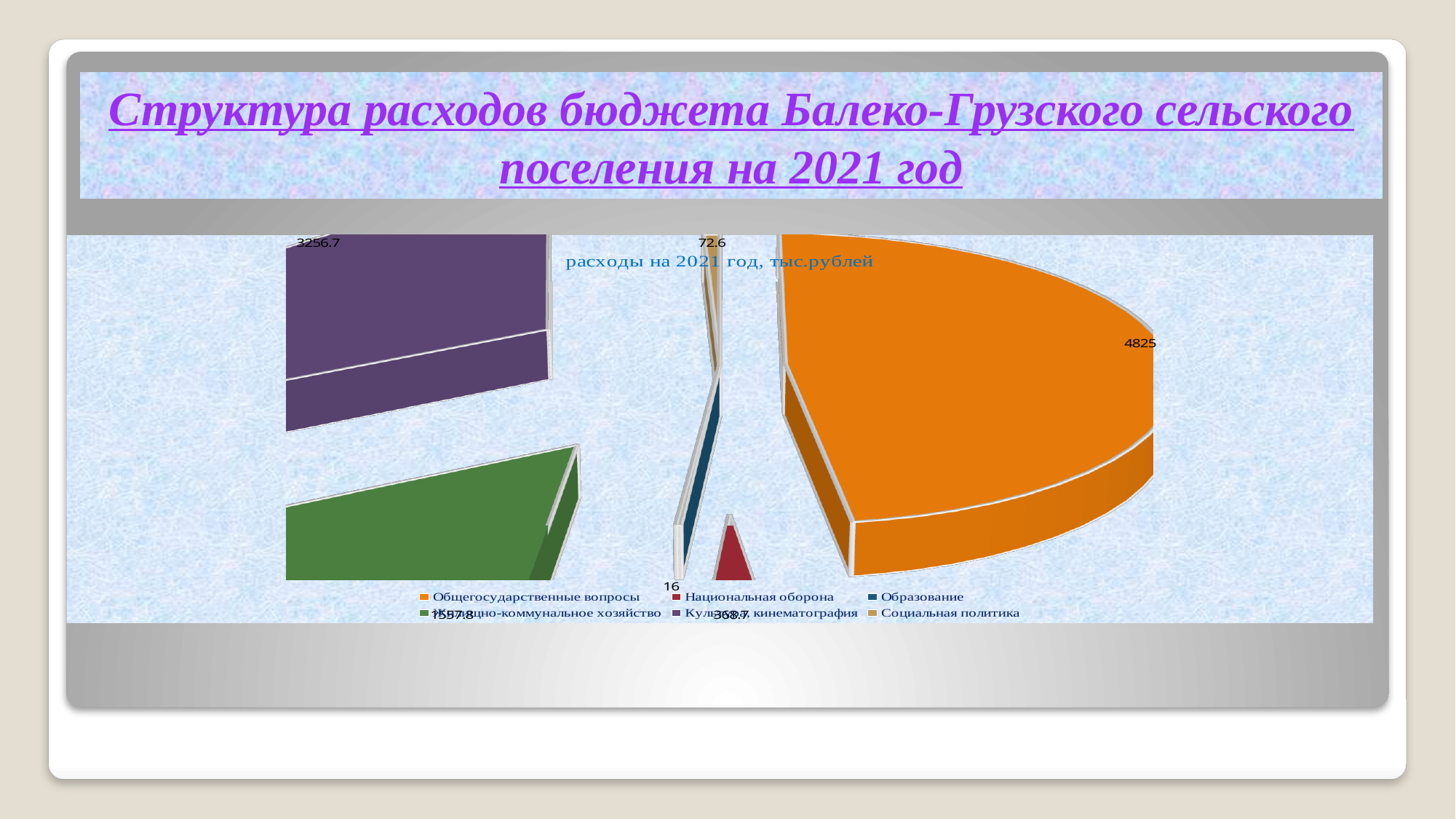
What is the value for Социальная политика? 72.6 Which category has the smallest slice of the pie? Образование Which category has the largest slice of the pie? Общегосударственные вопросы Which is larger, the value for Социальная политика or the value for Образование? Социальная политика Which is larger, the value for Культура, кинематография or the value for Жилищно-коммунальное хозяйство? Культура, кинематография What is the value for Культура, кинематография? 3256.7 What is the value for Общегосударственные вопросы? 4825 What is the title of the chart? расходы на 2021 год, тыс.рублей What kind of chart is shown on the slide? pie chart What is the value for Образование? 16 What is the difference between the values for Общегосударственные вопросы and Культура, кинематография? 1568.3 How many categories does the pie chart have? 6